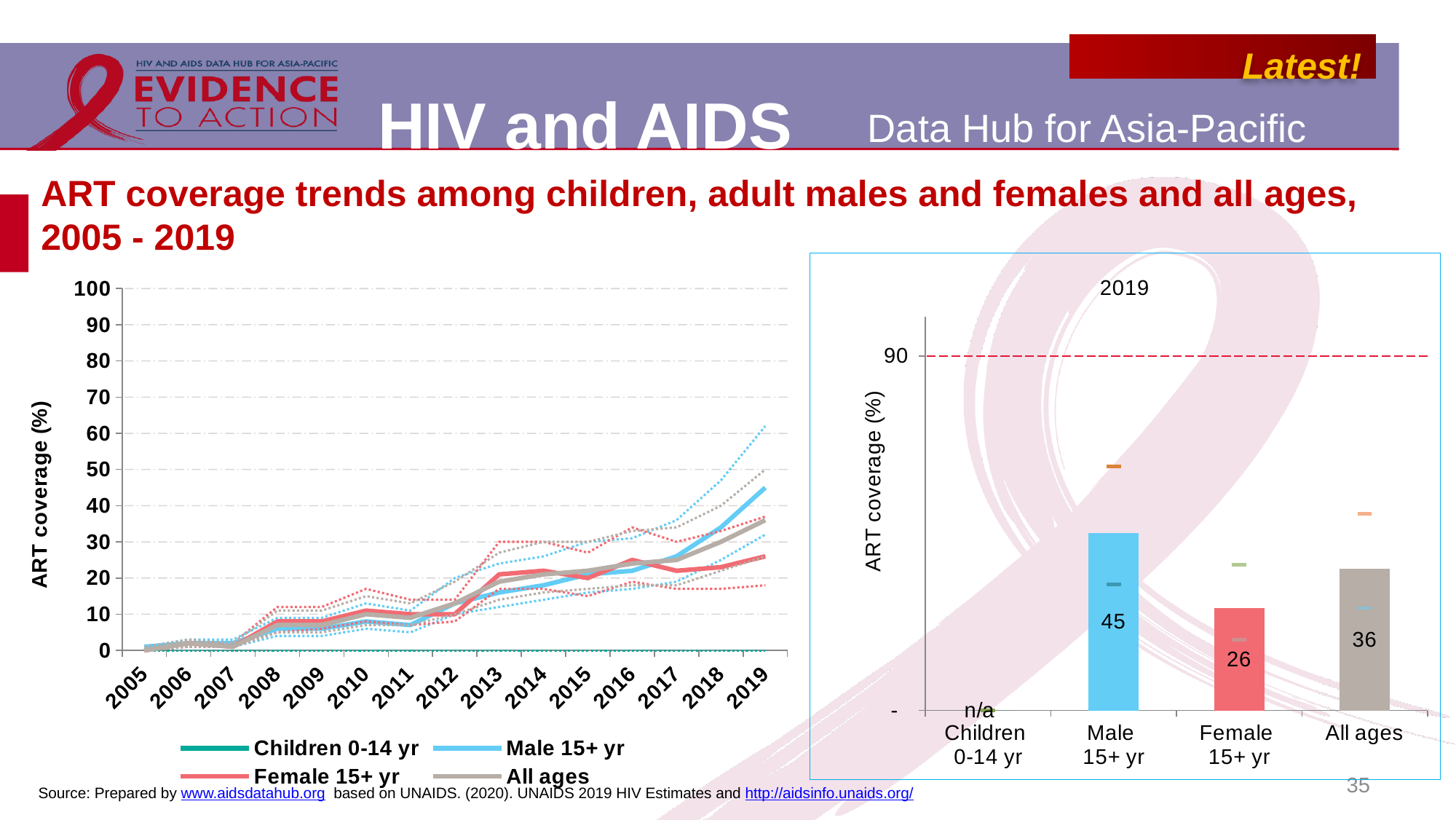
In the 2019 bar chart on the right, what is shown for Children 0-14 yr? n/a In the 2019 bar chart on the right, what is the difference between the Male 15+ yr and Female 15+ yr values? 19 In the 2019 bar chart on the right, what is the ART coverage value for Male 15+ yr? 45 In the 2019 bar chart on the right, what is the ART coverage value for Female 15+ yr? 26 In the line chart on the left, does the Male 15+ yr line rise or fall from 2005 to 2019? Rise What kind of chart is the chart on the right of the slide? Bar chart In the 2019 bar chart on the right, what is the ART coverage value for All ages? 36 How many series does the legend of the line chart on the left list? 4 How many years are shown on the x axis of the line chart on the left? 15 In the 2019 bar chart on the right, which category has the highest ART coverage? Male 15+ yr In the 2019 bar chart on the right, at what value is the horizontal dashed line drawn? 90 In the 2019 bar chart on the right, which is larger: All ages or Female 15+ yr? All ages